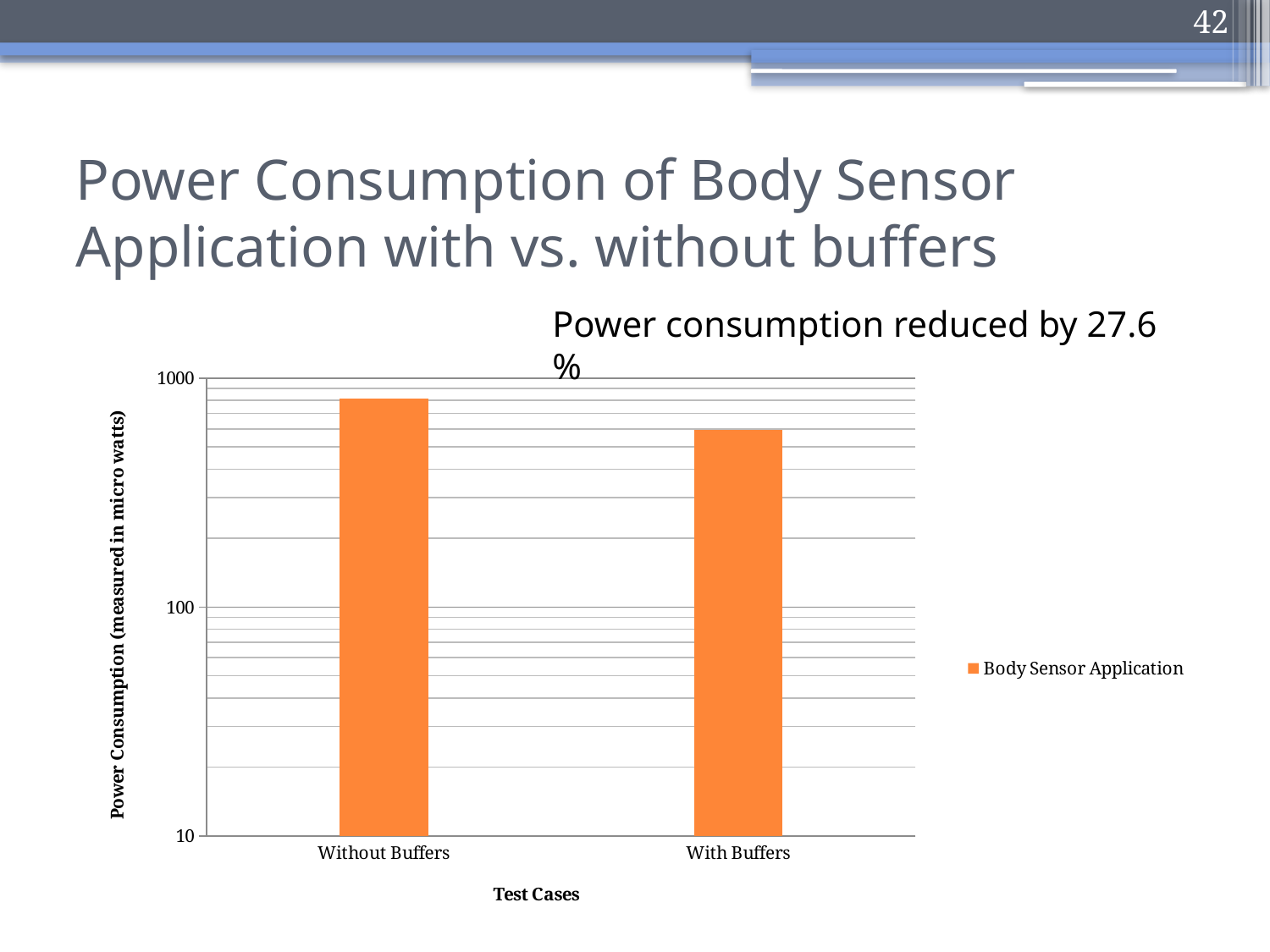
Is the power consumption for Without Buffers greater or less than 100? greater What kind of chart is shown on the slide? bar chart What series name is shown in the chart legend? Body Sensor Application Which test case has the lowest power consumption? With Buffers Which test case has the highest power consumption? Without Buffers How many test cases (categories) are plotted on the x axis? 2 Which has the larger power consumption, Without Buffers or With Buffers? Without Buffers Do the values fall or rise from Without Buffers to With Buffers? fall Is the power consumption for Without Buffers greater or less than 1000? less What is the title of the y axis? Power Consumption (measured in micro watts) How many series does the legend list? 1 Is the power consumption for With Buffers greater or less than 100? greater